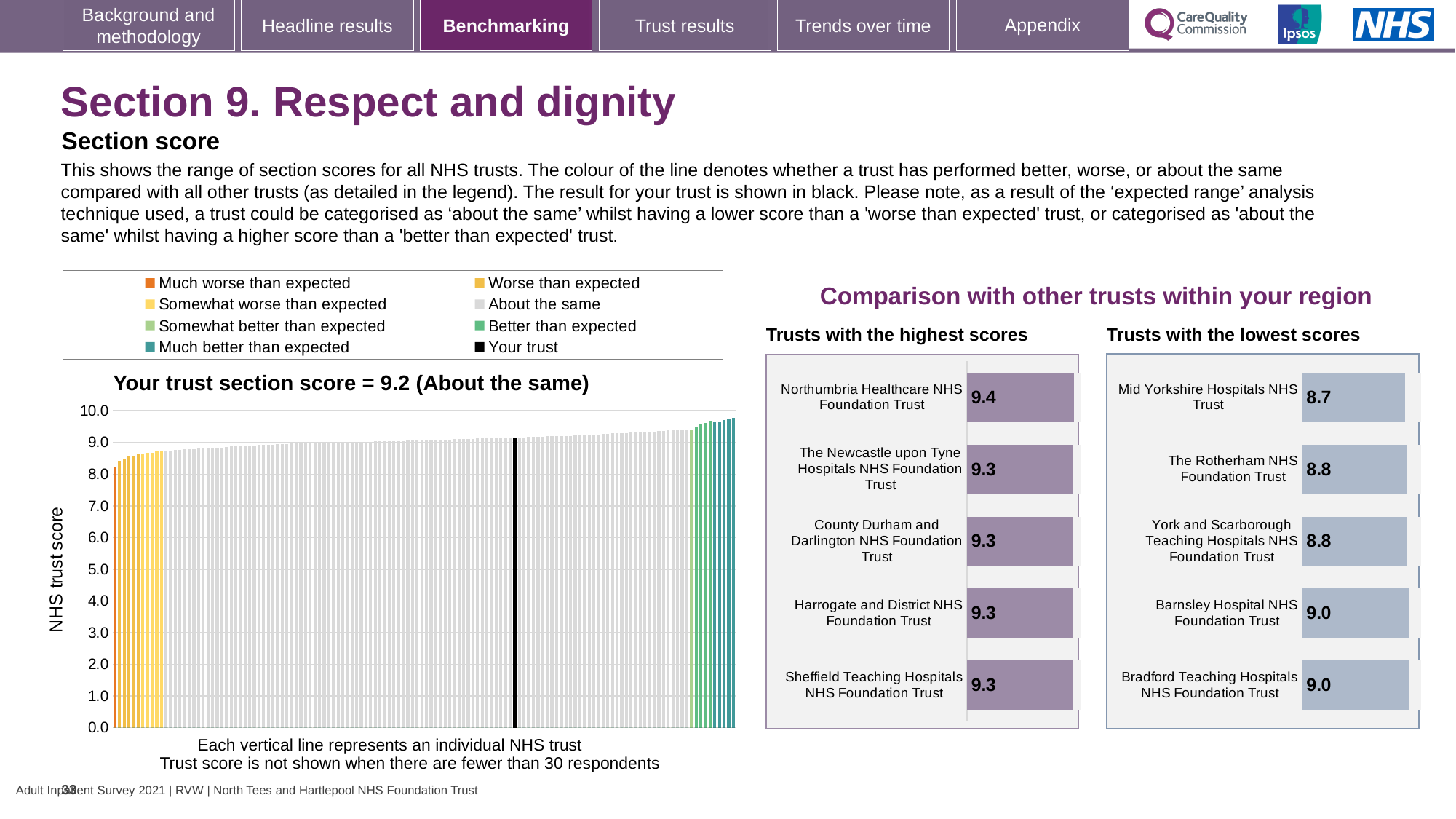
In the 'Trusts with the highest scores' chart, what is the score for Northumbria Healthcare NHS Foundation Trust? 9.4 In the 'Trusts with the lowest scores' chart, what is the difference between the scores of Bradford Teaching Hospitals NHS Foundation Trust and Mid Yorkshire Hospitals NHS Trust? 0.3 In the 'Your trust section score' chart, is the value of the highest bar greater or less than 10.0? less In the 'Trusts with the lowest scores' chart, which trust has the lowest score? Mid Yorkshire Hospitals NHS Trust In the 'Trusts with the highest scores' chart, which trust has the highest score? Northumbria Healthcare NHS Foundation Trust In the 'Your trust section score' chart, how many entries does the legend list? 8 In the 'Trusts with the highest scores' chart, how many trusts are shown? 5 What kind of chart is the 'Your trust section score' chart? bar chart In the 'Trusts with the lowest scores' chart, which has the higher score, Barnsley Hospital NHS Foundation Trust or The Rotherham NHS Foundation Trust? Barnsley Hospital NHS Foundation Trust In the 'Your trust section score' chart, what is the section score for your trust? 9.2 In the 'Your trust section score' chart, do the bar values rise or fall from left to right? rise In the 'Your trust section score' chart, what is the label on the vertical axis? NHS trust score